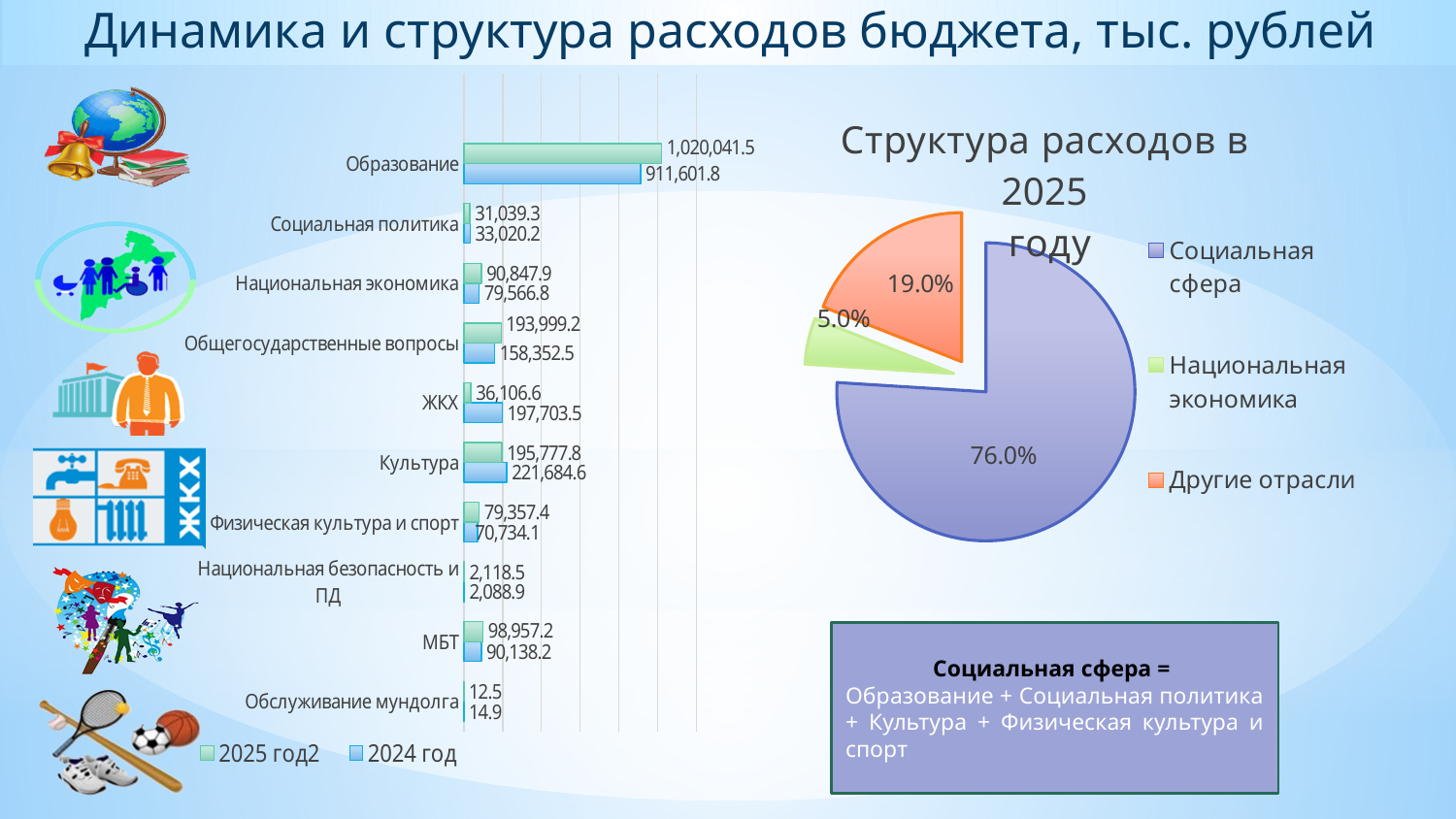
In the bar chart on the left, what is the value for ЖКХ in the 2024 год series? 197,703.5 How many series does the legend of the bar chart on the left list? 2 In the bar chart on the left, what is the value for Культура in the 2025 год2 series? 195,777.8 How many categories are shown in the bar chart on the left? 10 In the pie chart 'Структура расходов в 2025 году', what share does Социальная сфера have? 76.0% In the bar chart on the left, what is the difference between the 2025 год2 and 2024 год values for Общегосударственные вопросы? 35,646.7 In the bar chart on the left, which category has the lowest value in the 2025 год2 series? Обслуживание мундолга In the bar chart on the left, which category has the highest value in the 2024 год series? Образование In the bar chart on the left, what is the value for Образование in the 2025 год2 series? 1,020,041.5 What type of chart is the chart on the left of the slide? Bar chart In the bar chart on the left, which is larger for Социальная политика: the 2025 год2 value or the 2024 год value? 2024 год In the pie chart 'Структура расходов в 2025 году', which slice is the smallest? Национальная экономика